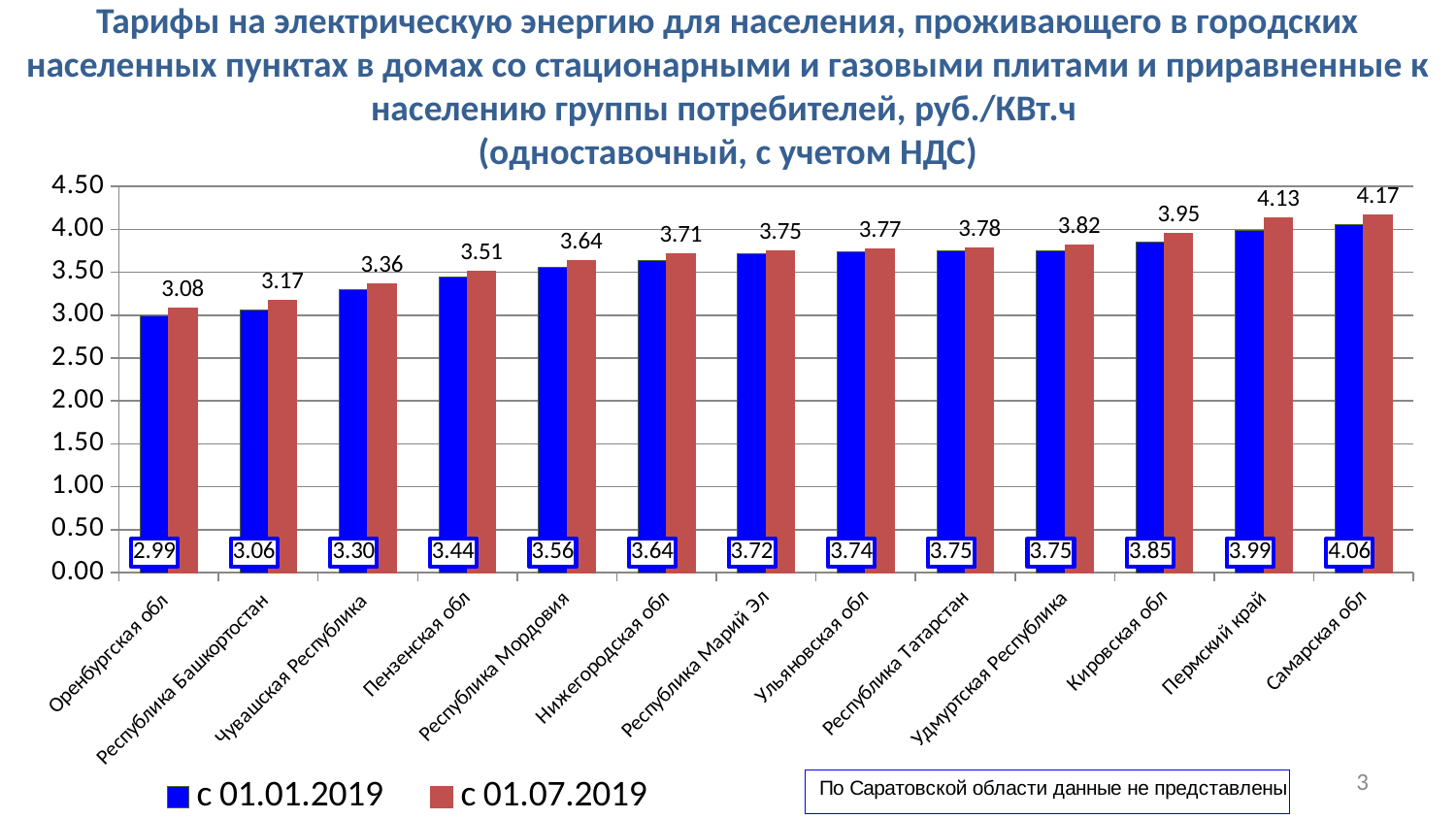
What is the value for Республика Мордовия in the с 01.07.2019 series? 3.64 What kind of chart is shown on the slide? bar chart Do the с 01.07.2019 values rise or fall from left to right along the x axis? rise Which region has the highest value in the с 01.01.2019 series? Самарская обл Which is larger: the с 01.01.2019 value for Кировская обл or the с 01.07.2019 value for Удмуртская Республика? Кировская обл (3.85) How many series does the legend list? 2 Is the с 01.07.2019 value for Чувашская Республика greater or less than 3.50? less Which region has the lowest value in the с 01.07.2019 series? Оренбургская обл What is the difference between the с 01.07.2019 and с 01.01.2019 values for Пермский край? 0.14 What is the value for Пензенская обл in the с 01.01.2019 series? 3.44 How many regions are shown on the x axis? 13 What is the value for Самарская обл in the с 01.07.2019 series? 4.17